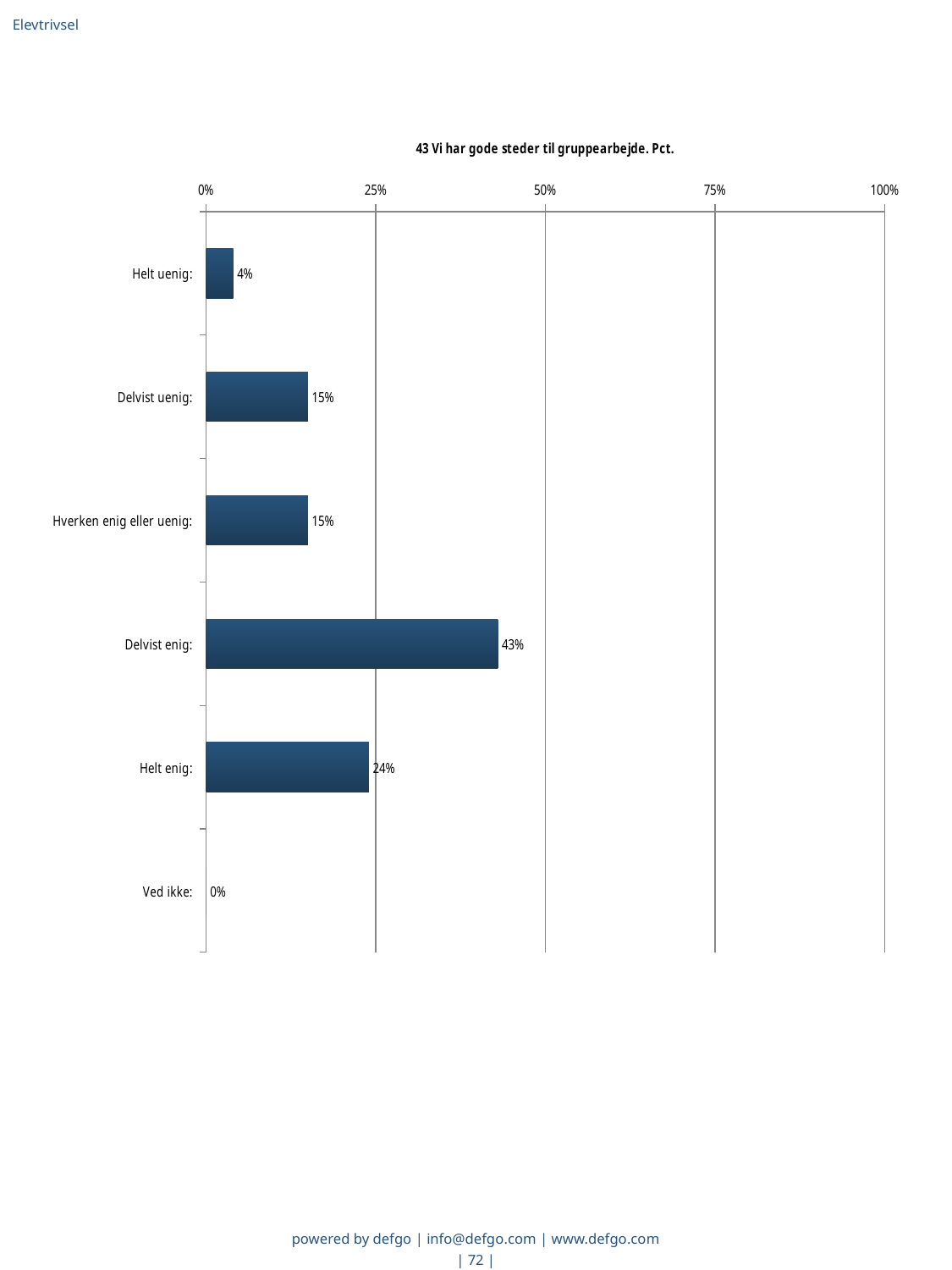
What kind of chart is shown on the slide? bar chart How many categories are shown on the chart? 6 What is the difference between the values for "Delvist enig:" and "Helt enig:"? 19% What is the value for "Helt enig:"? 24% Which category has the lowest value? Ved ikke: Which is larger, the value for "Helt enig:" or the value for "Delvist uenig:"? Helt enig: What is the title of the chart? 43 Vi har gode steder til gruppearbejde. Pct. What is the value for "Delvist enig:"? 43% What is the value for "Ved ikke:"? 0% Which category has the highest value? Delvist enig: Is the value for "Delvist enig:" greater or less than 25%? greater What is the value for "Helt uenig:"? 4%